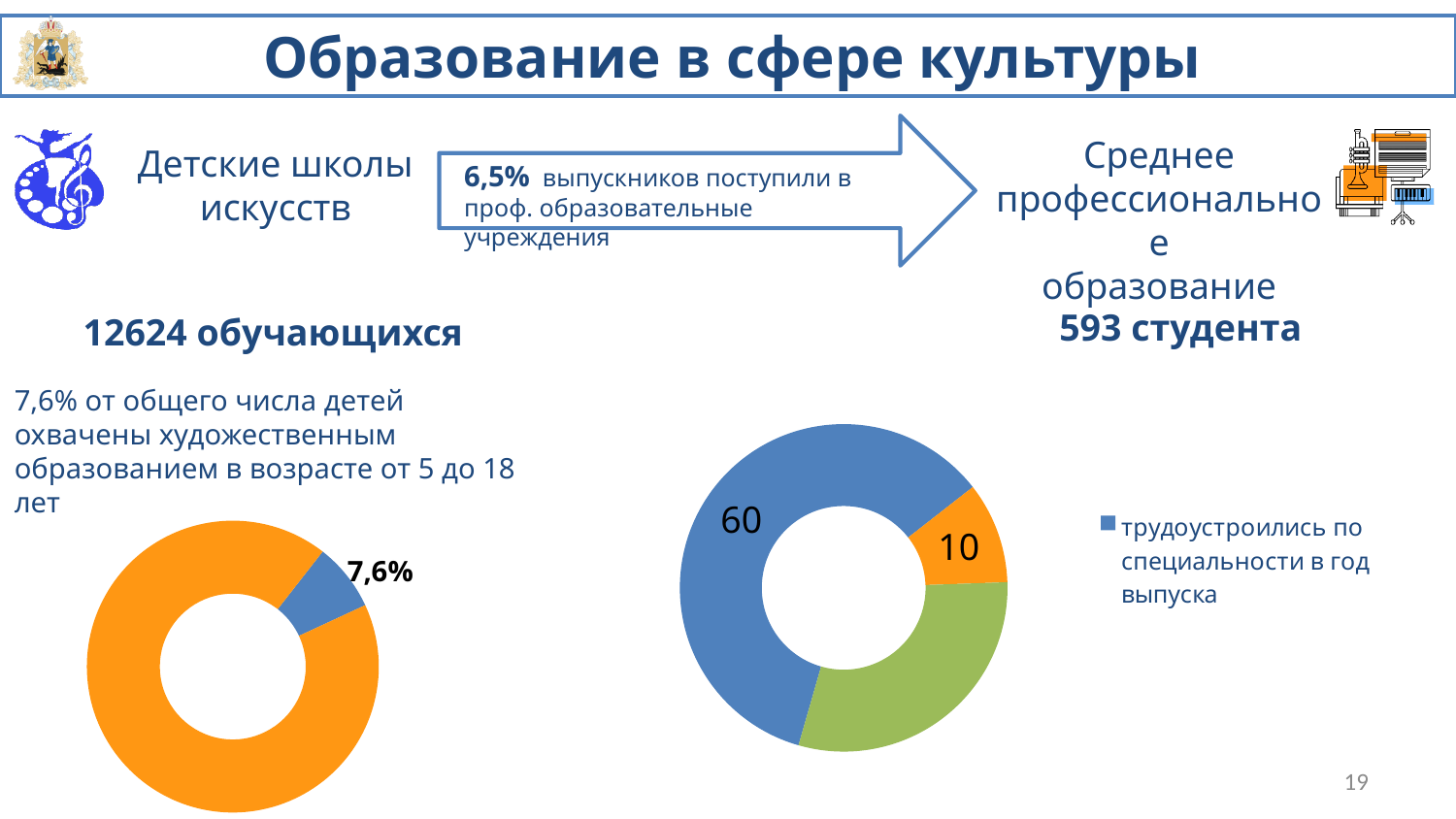
What kind of chart is the chart on the left of the slide? doughnut chart In the chart on the right of the slide, what value is printed on the blue slice? 60 In the chart on the right of the slide, what value is printed on the orange slice? 10 In the chart on the right of the slide, which slice is the largest? the blue slice (60) How many slices does the chart on the right of the slide have? 3 In the chart on the right of the slide, what is the difference between the blue slice value and the orange slice value? 50 In the chart on the right of the slide, which slice is the smallest? the orange slice (10) What legend entry is shown next to the chart on the right of the slide? трудоустроились по специальности в год выпуска In the chart on the left of the slide, what value is printed on the blue slice? 7,6% How many slices does the chart on the left of the slide have? 2 What kind of chart is the chart on the right of the slide? doughnut chart In the chart on the left of the slide, which slice is larger, the orange one or the blue one? the orange one